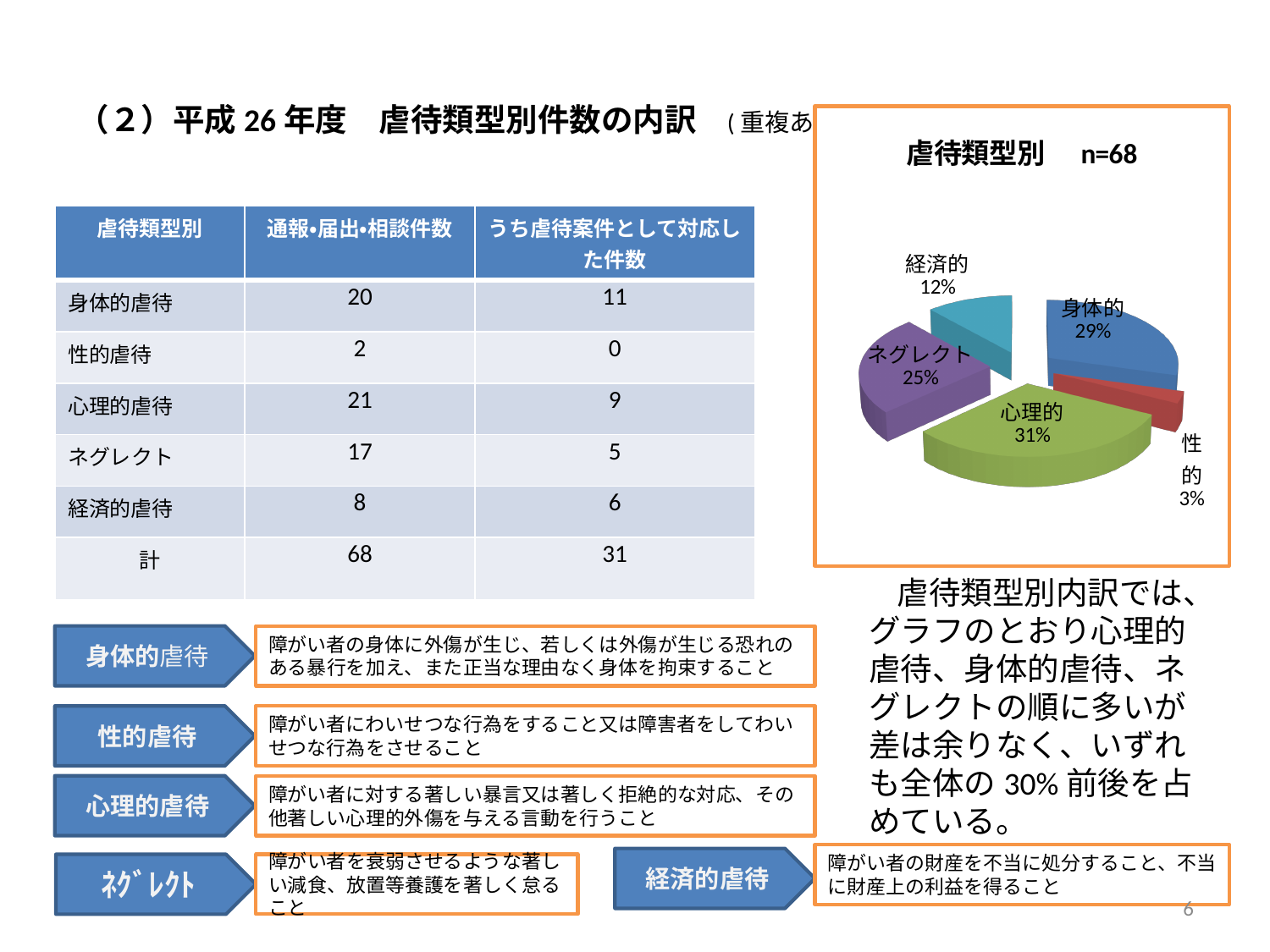
What percentage does the 性的 slice show in the pie chart? 3% What is the title of the pie chart? 虐待類型別 n=68 What percentage does the ネグレクト slice show in the pie chart? 25% What percentage does the 経済的 slice show in the pie chart? 12% Which category has the largest share in the pie chart? 心理的 What percentage does the 身体的 slice show in the pie chart? 29% What percentage does the 心理的 slice show in the pie chart? 31% Which category has the smallest share in the pie chart? 性的 What is the difference in percentage points between the 心理的 and ネグレクト slices in the pie chart? 6 What kind of chart is shown on the slide? pie chart How many slices does the pie chart have? 5 In the pie chart, which is larger: the 経済的 slice or the ネグレクト slice? ネグレクト